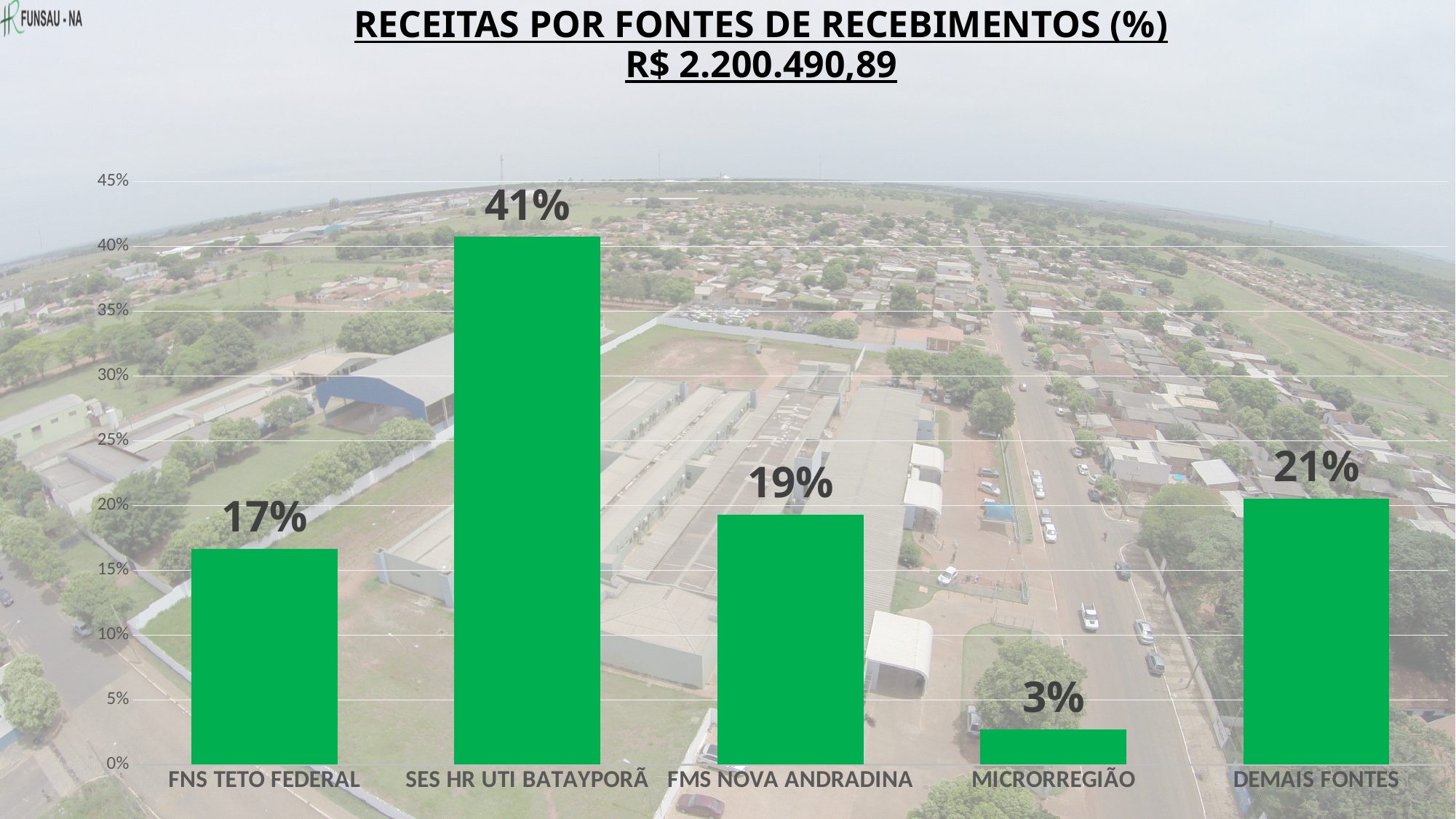
What kind of chart is shown on the slide? Bar chart What is the difference between the values for SES HR UTI BATAYPORÃ and DEMAIS FONTES? 20% Which is larger, the value for FMS NOVA ANDRADINA or the value for FNS TETO FEDERAL? FMS NOVA ANDRADINA Is the value for DEMAIS FONTES greater or less than 20%? greater What is the value for DEMAIS FONTES? 21% What is the value for FNS TETO FEDERAL? 17% How many categories are shown in the chart? 5 Which category has the lowest value? MICRORREGIÃO What total amount in R$ is shown in the chart title? R$ 2.200.490,89 Which category has the highest value? SES HR UTI BATAYPORÃ What is the value for SES HR UTI BATAYPORÃ? 41% What is the value for MICRORREGIÃO? 3%